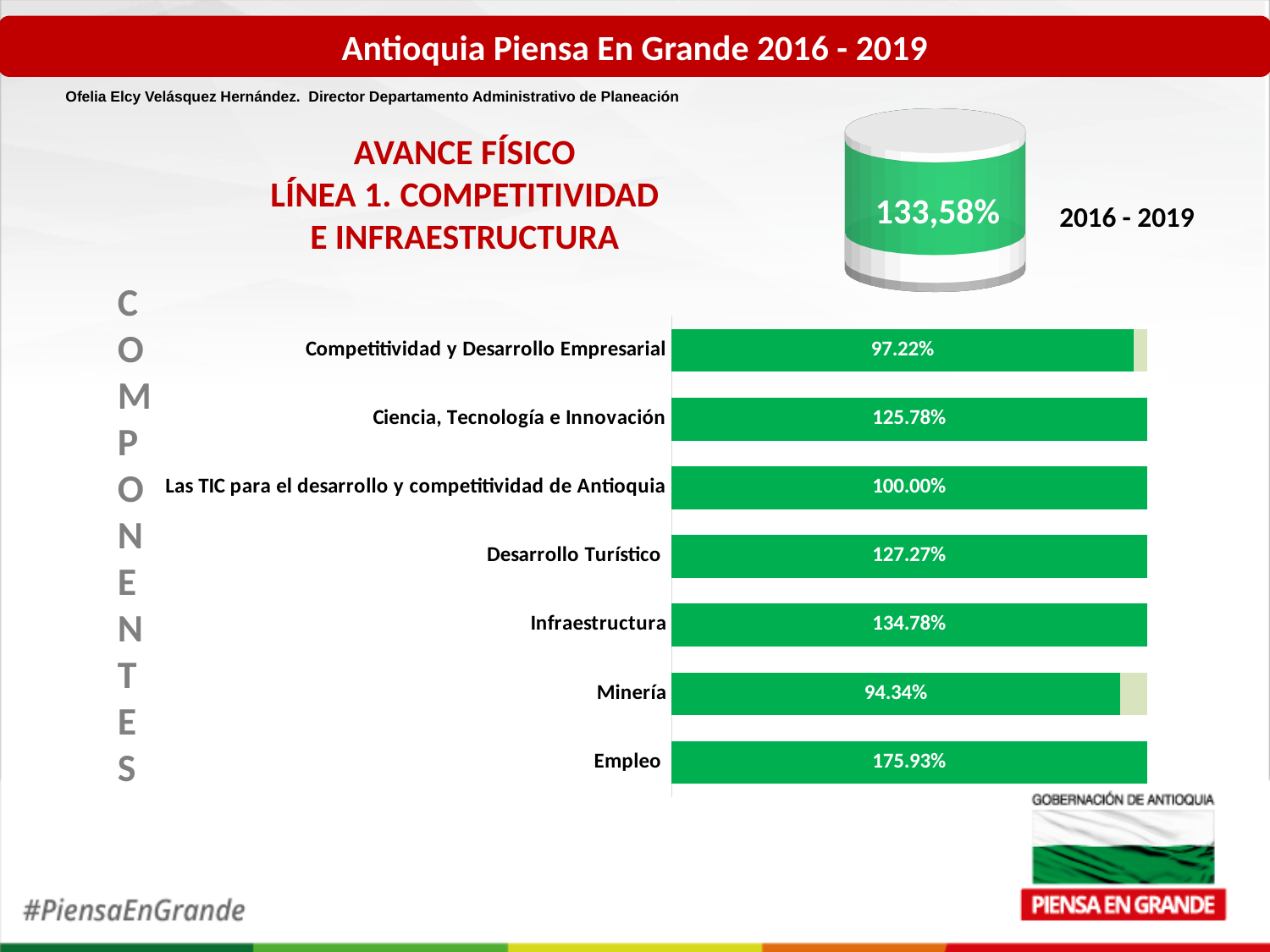
How many components are shown in the chart? 7 What is the value shown for Las TIC para el desarrollo y competitividad de Antioquia? 100.00% What is the difference between the values for Infraestructura and Desarrollo Turístico? 7.51% What is the difference between the values for Empleo and Minería? 81.59% Which has a larger value, Competitividad y Desarrollo Empresarial or Ciencia, Tecnología e Innovación? Ciencia, Tecnología e Innovación What is the value shown for Empleo? 175.93% What is the value shown for Ciencia, Tecnología e Innovación? 125.78% What is the value shown for Infraestructura? 134.78% What overall percentage is shown in the cylinder graphic next to the title? 133,58% Which component has the lowest value? Minería What kind of chart is shown on the slide? Bar chart Which component has the highest value? Empleo